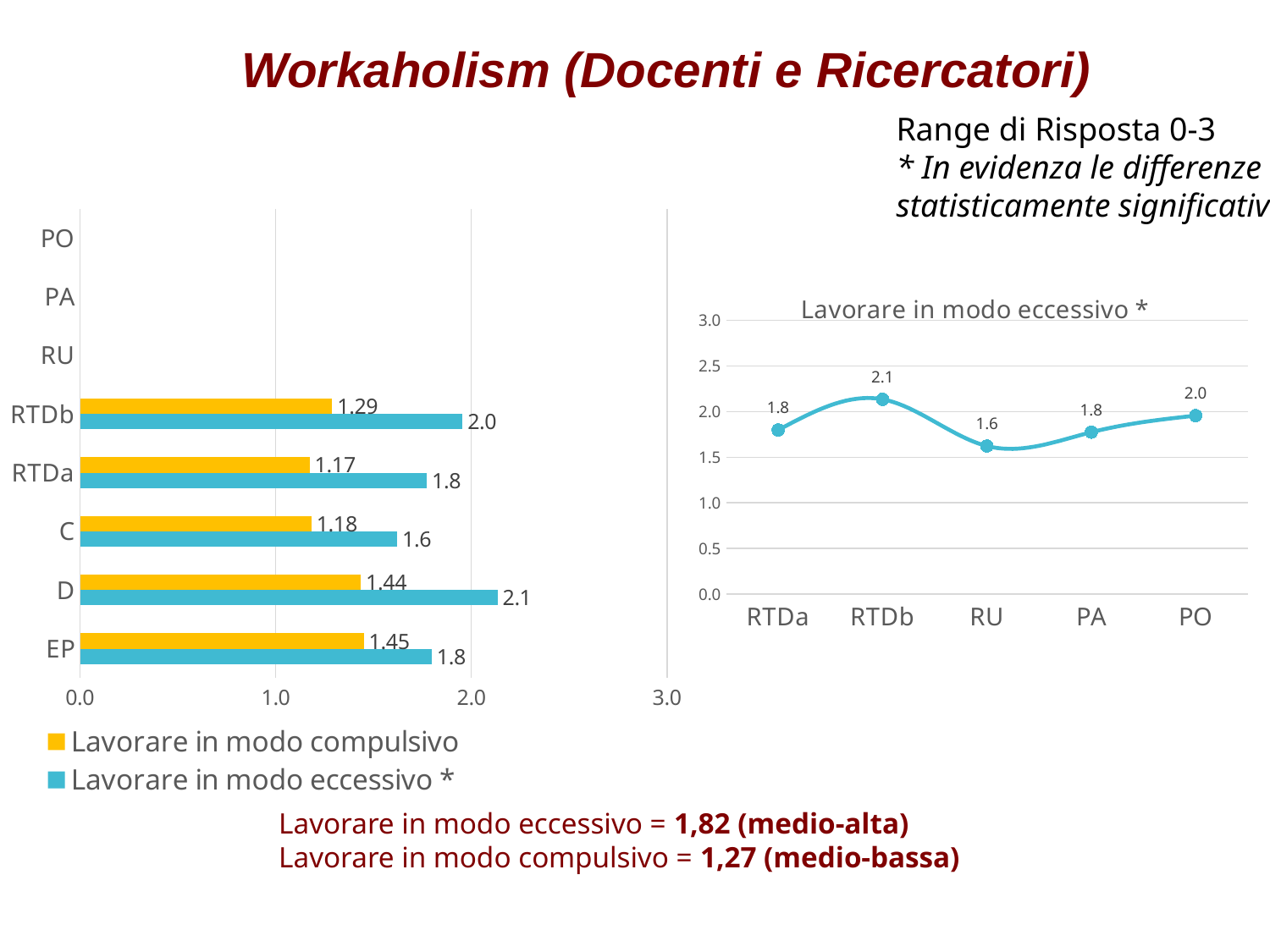
In the bar chart on the left, which category has the lowest value for 'Lavorare in modo eccessivo *'? C What type of chart is the chart titled 'Lavorare in modo eccessivo *' on the right? Line chart In the bar chart on the left, what is the value of 'Lavorare in modo eccessivo *' for D? 2.1 In the bar chart on the left, is the 'Lavorare in modo compulsivo' value larger for D or for RTDa? D In the bar chart on the left, what is the value of 'Lavorare in modo compulsivo' for RTDb? 1.29 In the chart titled 'Lavorare in modo eccessivo *' on the right, what is the value for RU? 1.6 In the bar chart on the left, how many series does the legend list? 2 In the chart titled 'Lavorare in modo eccessivo *' on the right, how many categories are shown on the x axis? 5 In the bar chart on the left, which category has the highest value for 'Lavorare in modo compulsivo'? EP What type of chart is the chart on the left? Bar chart In the bar chart on the left, what is the difference between 'Lavorare in modo eccessivo *' and 'Lavorare in modo compulsivo' for C? 0.42 In the chart titled 'Lavorare in modo eccessivo *' on the right, which category has the highest value? RTDb